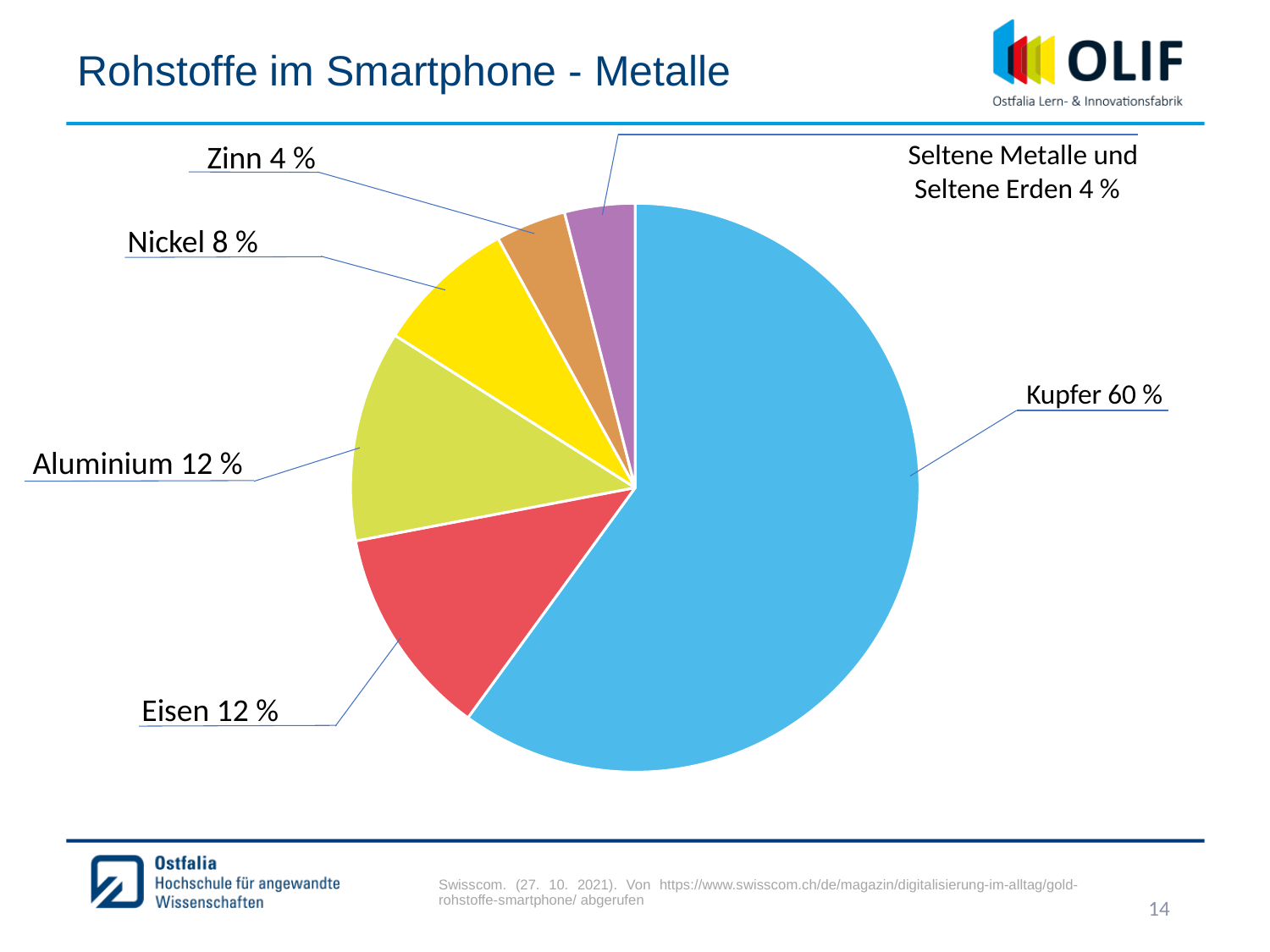
What colour is the Kupfer slice? blue What kind of chart is shown on the slide? pie chart What is the difference between the shares of Kupfer and Eisen? 48 % What is the difference between the shares of Nickel and Zinn? 4 % What share of the pie does Kupfer have? 60 % Which is larger, the share of Nickel or the share of Aluminium? Aluminium How many slices does the pie chart have? 6 What share of the pie does Aluminium have? 12 % What share of the pie does Zinn have? 4 % Which category has the largest slice of the pie? Kupfer What share of the pie does Nickel have? 8 % What is the title of the slide containing the pie chart? Rohstoffe im Smartphone - Metalle